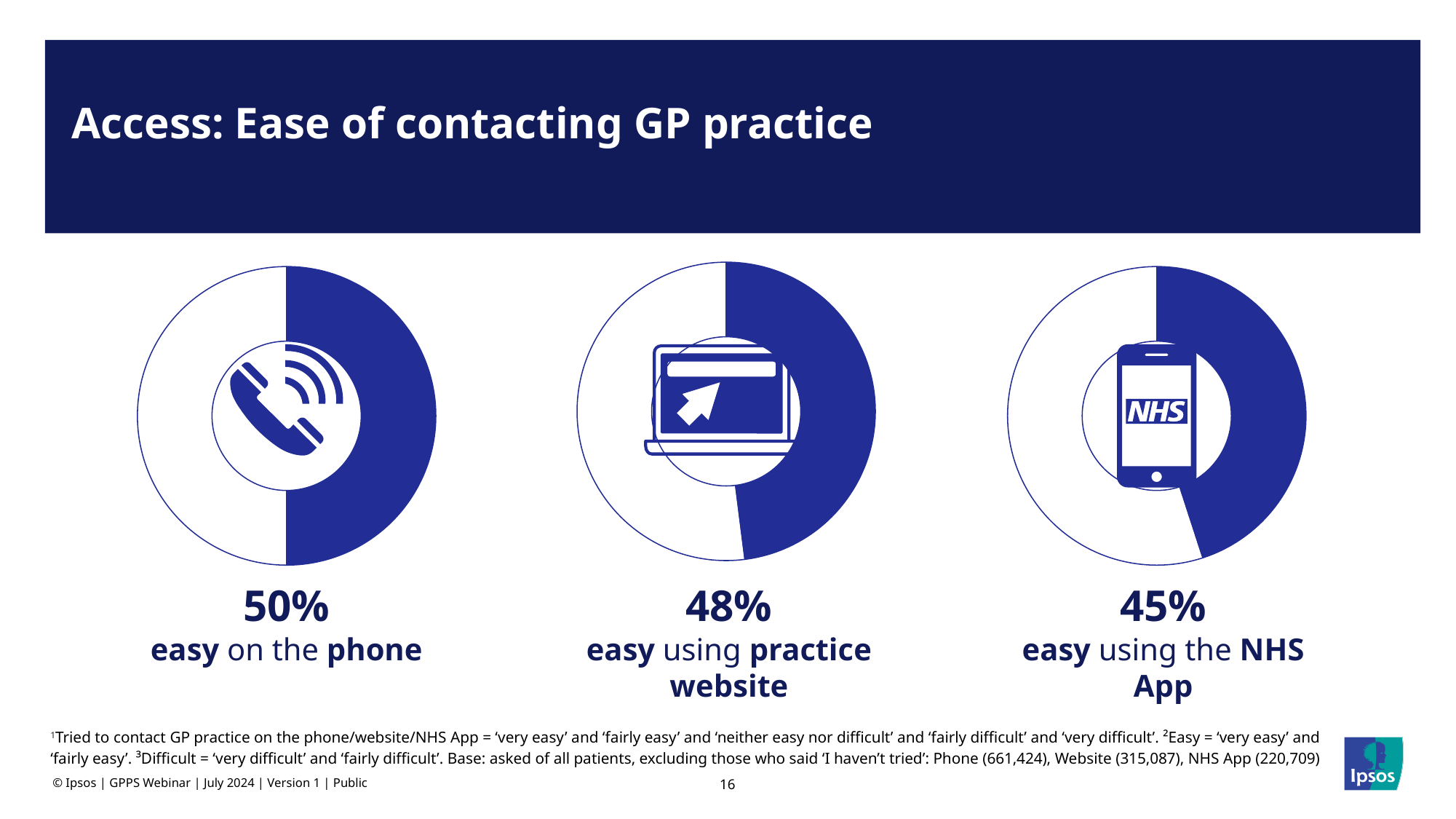
What kind of chart is used to show each percentage on the slide? Donut (pie) chart Which has a higher percentage of patients saying it was easy: the practice website or the NHS App? Practice website How many donut charts are shown on the slide? 3 What colour is the filled portion of each donut chart? Dark blue What percentage of patients found it easy to contact their GP practice using the NHS App? 45% What is the difference in percentage points between the phone and the practice website values? 2 percentage points What percentage of patients found it easy to contact their GP practice using the practice website? 48% What is the title of the slide containing the three donut charts? Access: Ease of contacting GP practice Which contact method has the highest percentage of patients saying it was easy? Phone What percentage of patients found it easy to contact their GP practice on the phone? 50% Which contact method has the lowest percentage of patients saying it was easy? NHS App What is the difference in percentage points between the phone and the NHS App values? 5 percentage points